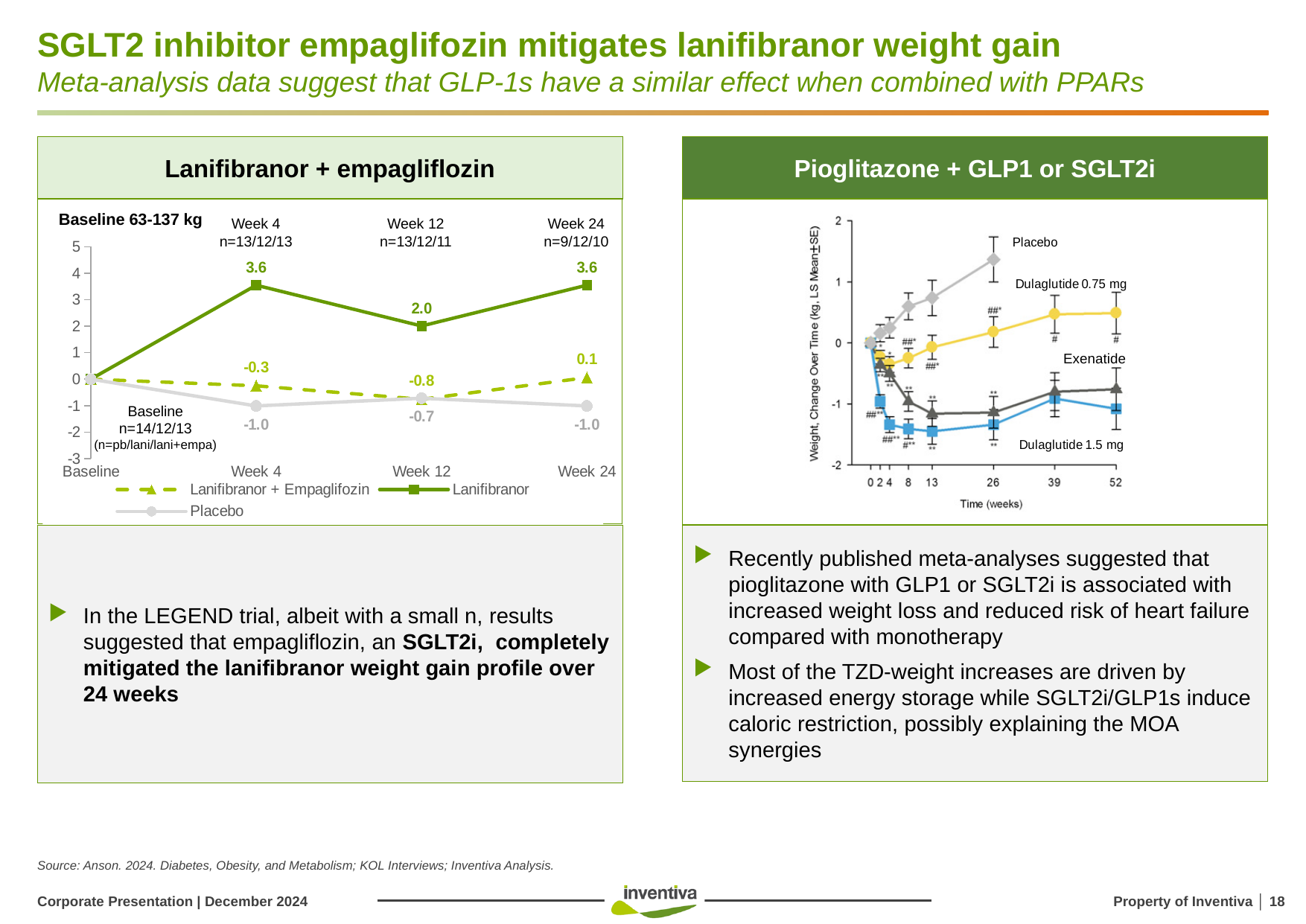
In the 'Lanifibranor + empagliflozin' chart, what is the value for Placebo at Week 12? -0.7 In the 'Lanifibranor + empagliflozin' chart, which series has the highest value at Week 4? Lanifibranor In the 'Lanifibranor + empagliflozin' chart, how many series does the legend list? 3 In the 'Pioglitazone + GLP1 or SGLT2i' chart, is the Placebo value at week 26 greater or less than 1? greater In the 'Lanifibranor + empagliflozin' chart, which series has the lowest value at Week 24? Placebo In the 'Lanifibranor + empagliflozin' chart, what is the difference between the Lanifibranor and Placebo values at Week 24? 4.6 In the 'Lanifibranor + empagliflozin' chart, what is the value for Lanifibranor at Week 12? 2.0 In the 'Pioglitazone + GLP1 or SGLT2i' chart, does the Placebo series rise or fall from week 0 to week 26? Rise What kind of chart is the 'Lanifibranor + empagliflozin' chart? Line chart In the 'Lanifibranor + empagliflozin' chart, which is larger at Week 12: the Lanifibranor + Empagliflozin value or the Placebo value? Placebo In the 'Lanifibranor + empagliflozin' chart, what is the value for Lanifibranor + Empagliflozin at Week 24? 0.1 In the 'Lanifibranor + empagliflozin' chart, how many time points are shown on the x axis? 4